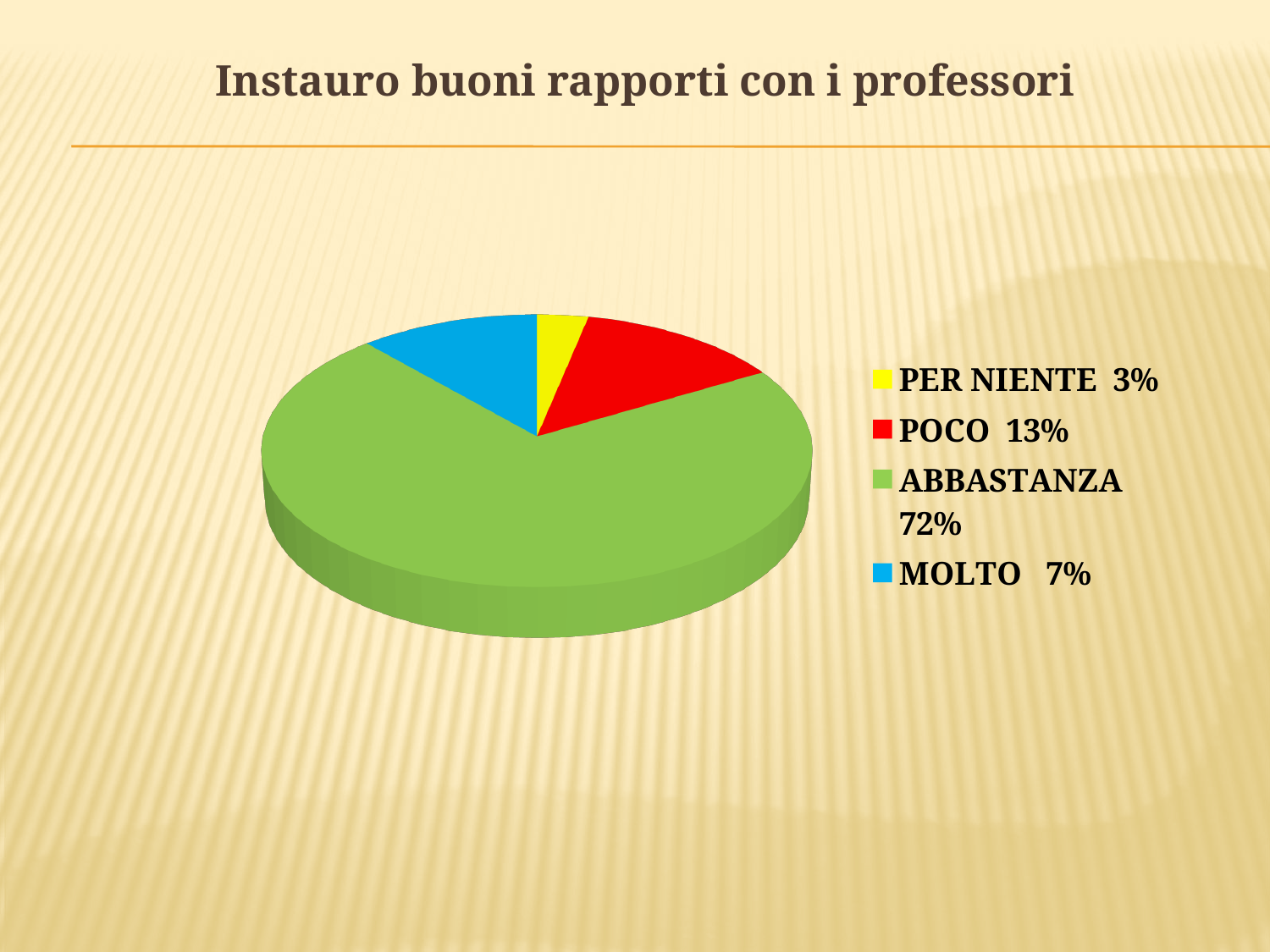
What is the value for PER NIENTE? 3% What is the difference between the values for POCO and MOLTO? 6% What is the difference between the values for ABBASTANZA and POCO? 59% What share of the pie does ABBASTANZA represent? 72% What colour is the slice for POCO? Red Which category has the smallest slice? PER NIENTE Which is larger, the value for MOLTO or the value for PER NIENTE? MOLTO Which category has the largest slice? ABBASTANZA What kind of chart is shown on the slide? Pie chart What is the value for MOLTO? 7% How many categories does the pie chart show? 4 What is the value for POCO? 13%